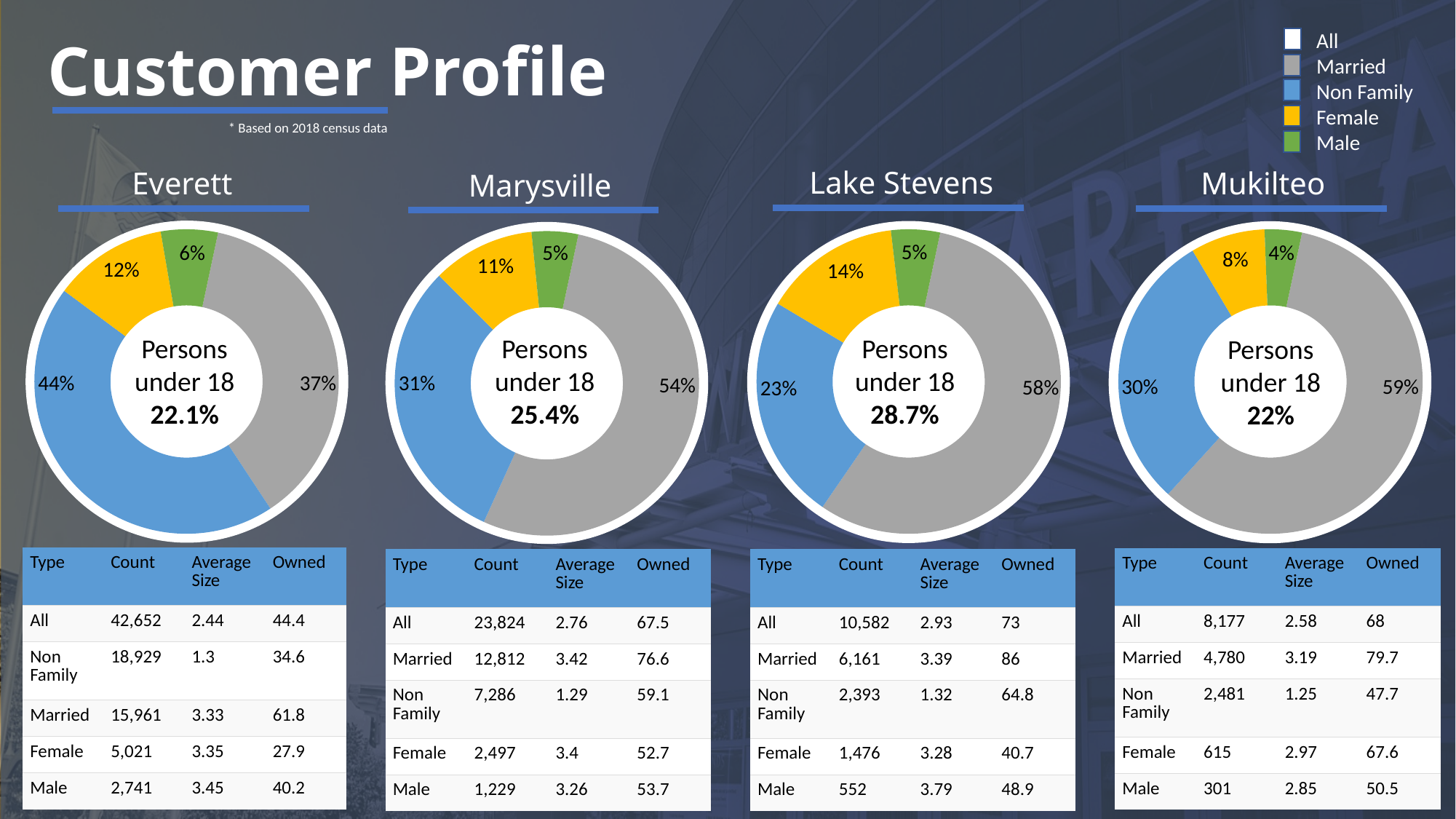
In the Lake Stevens chart, which slice is the smallest? Male In the Mukilteo chart, what is the difference between the Married and Non Family percentages? 29% In the Lake Stevens chart, what percentage is shown for the Female slice? 14% In the Marysville chart, what percentage is shown for the Married slice? 54% In the Everett chart, which slice is the largest? Non Family How many slices does the Everett donut chart have? 4 According to the legend, which colour represents Non Family? Blue In the Marysville chart, which is larger, the Female slice or the Male slice? Female In the Mukilteo chart, what percentage is shown for the Male slice? 4% What type of chart is used for each city on the slide? Donut (pie) chart What percentage of persons under 18 is shown in the centre of the Lake Stevens chart? 28.7% In the Everett chart, what percentage is shown for the Non Family slice? 44%